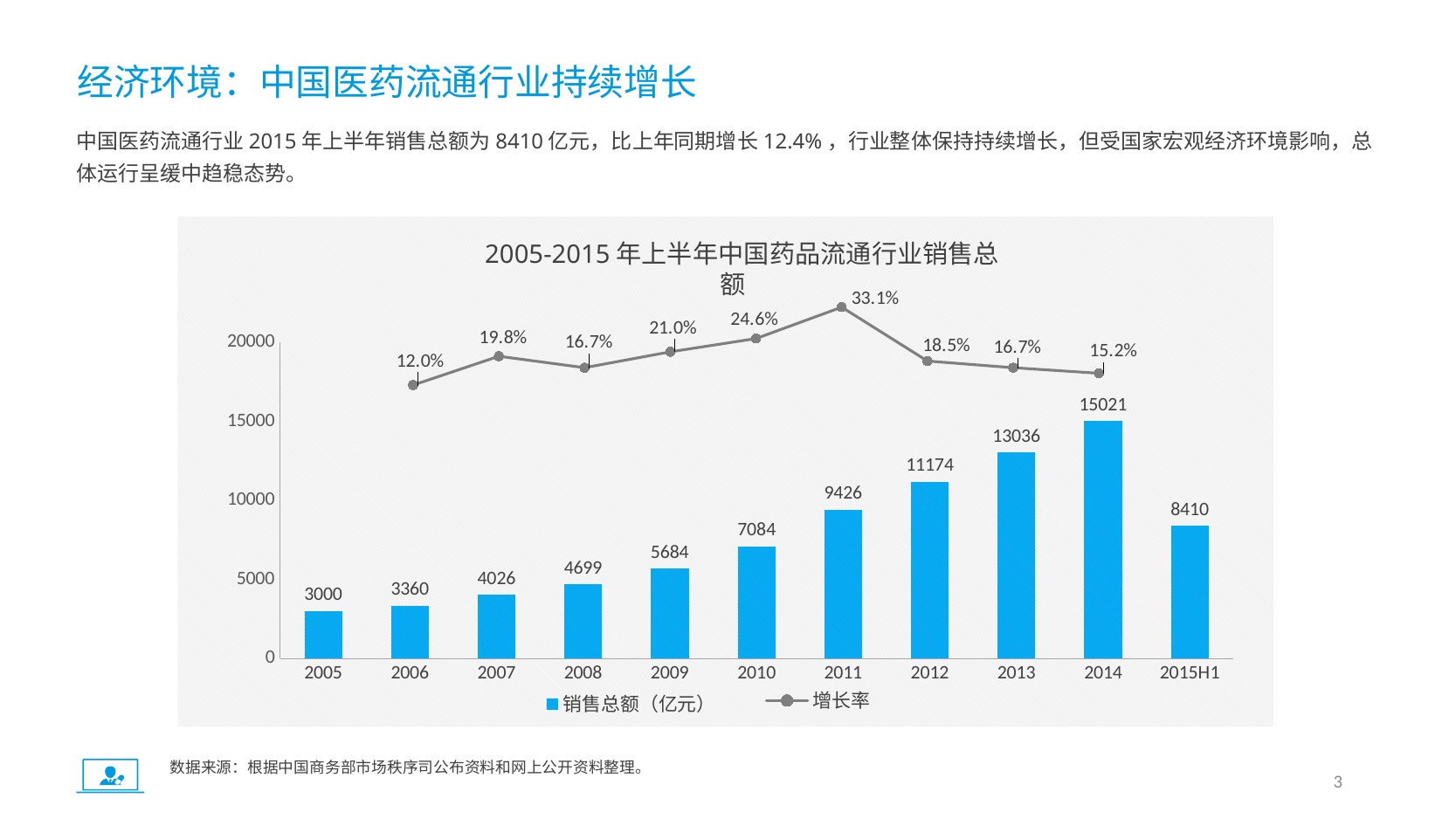
What kind of chart is used for the 销售总额 series? Bar chart What is the 销售总额 value for 2015H1? 8410 What is the 增长率 value shown for 2011? 33.1% Which year has the lowest 销售总额 bar? 2005 Do the 销售总额 bars rise or fall from 2005 to 2014? Rise Which year has the highest 增长率 point on the line? 2011 Which year has the highest 销售总额 bar? 2014 What is the difference between the 销售总额 values for 2014 and 2013? 1985 How many bars (categories) are shown on the x axis? 11 Which is larger, the 销售总额 for 2012 or for 2015H1? 2012 How many series does the legend list? 2 What is the 销售总额 value for 2011? 9426